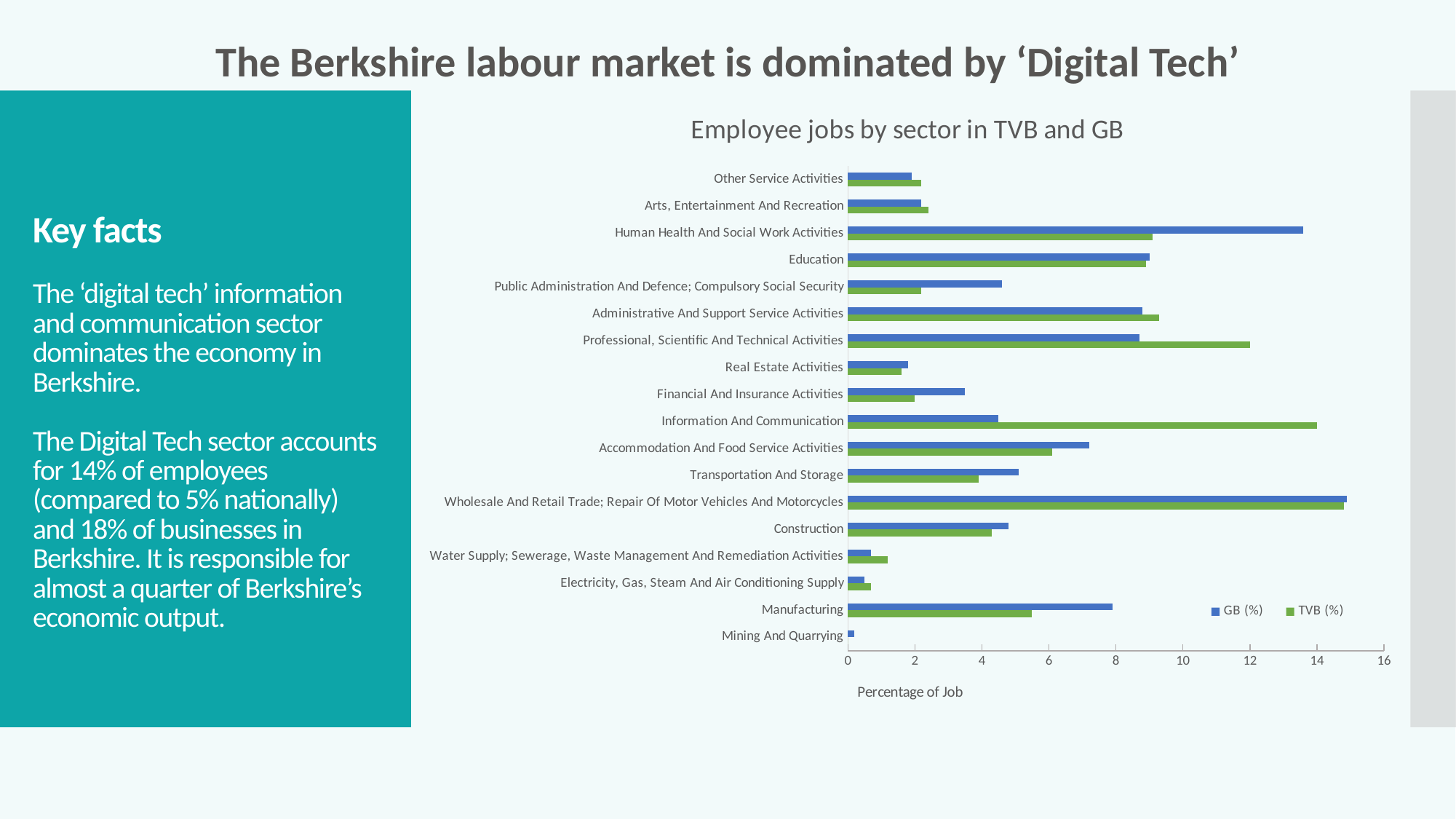
What is the label of the horizontal axis? Percentage of Job Is the GB (%) value for Information And Communication greater or less than 6? less Is the TVB (%) value for Professional, Scientific And Technical Activities greater or less than 10? greater How many series does the chart legend list? 2 Which sector has the highest GB (%) value? Wholesale And Retail Trade; Repair Of Motor Vehicles And Motorcycles For Human Health And Social Work Activities, which is larger: the GB (%) value or the TVB (%) value? GB (%) What type of chart is shown on the slide? Bar chart Is the TVB (%) value for Information And Communication greater or less than 12? greater What is the title of the chart? Employee jobs by sector in TVB and GB How many sectors (categories) are shown on the chart? 18 For Manufacturing, which is larger: the GB (%) value or the TVB (%) value? GB (%) Which sector has the lowest GB (%) value? Mining And Quarrying